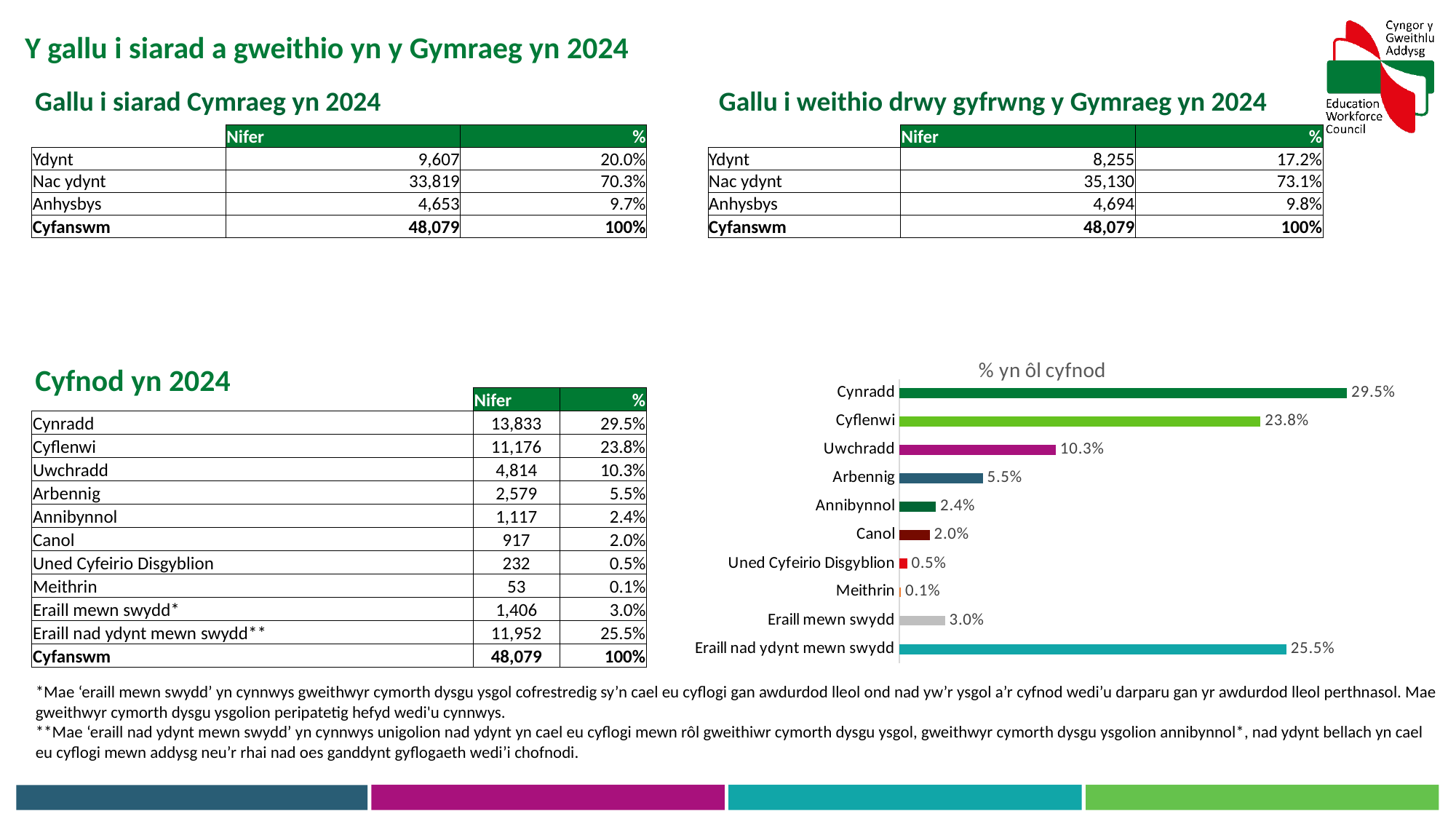
What is the title of the bar chart on the slide? % yn ôl cyfnod In the '% yn ôl cyfnod' chart, what is the value for Eraill nad ydynt mewn swydd? 25.5% How many categories are shown in the '% yn ôl cyfnod' chart? 10 In the '% yn ôl cyfnod' chart, which category has the highest value? Cynradd In the '% yn ôl cyfnod' chart, what is the value for Uwchradd? 10.3% What kind of chart is shown on the slide? bar chart In the '% yn ôl cyfnod' chart, what is the difference between Eraill nad ydynt mewn swydd and Eraill mewn swydd? 22.5% In the '% yn ôl cyfnod' chart, what is the value for Canol? 2.0% In the '% yn ôl cyfnod' chart, what is the value for Cynradd? 29.5% In the '% yn ôl cyfnod' chart, what is the difference between Cynradd and Cyflenwi? 5.7% In the '% yn ôl cyfnod' chart, which category has the lowest value? Meithrin In the '% yn ôl cyfnod' chart, which is larger: Arbennig or Annibynnol? Arbennig